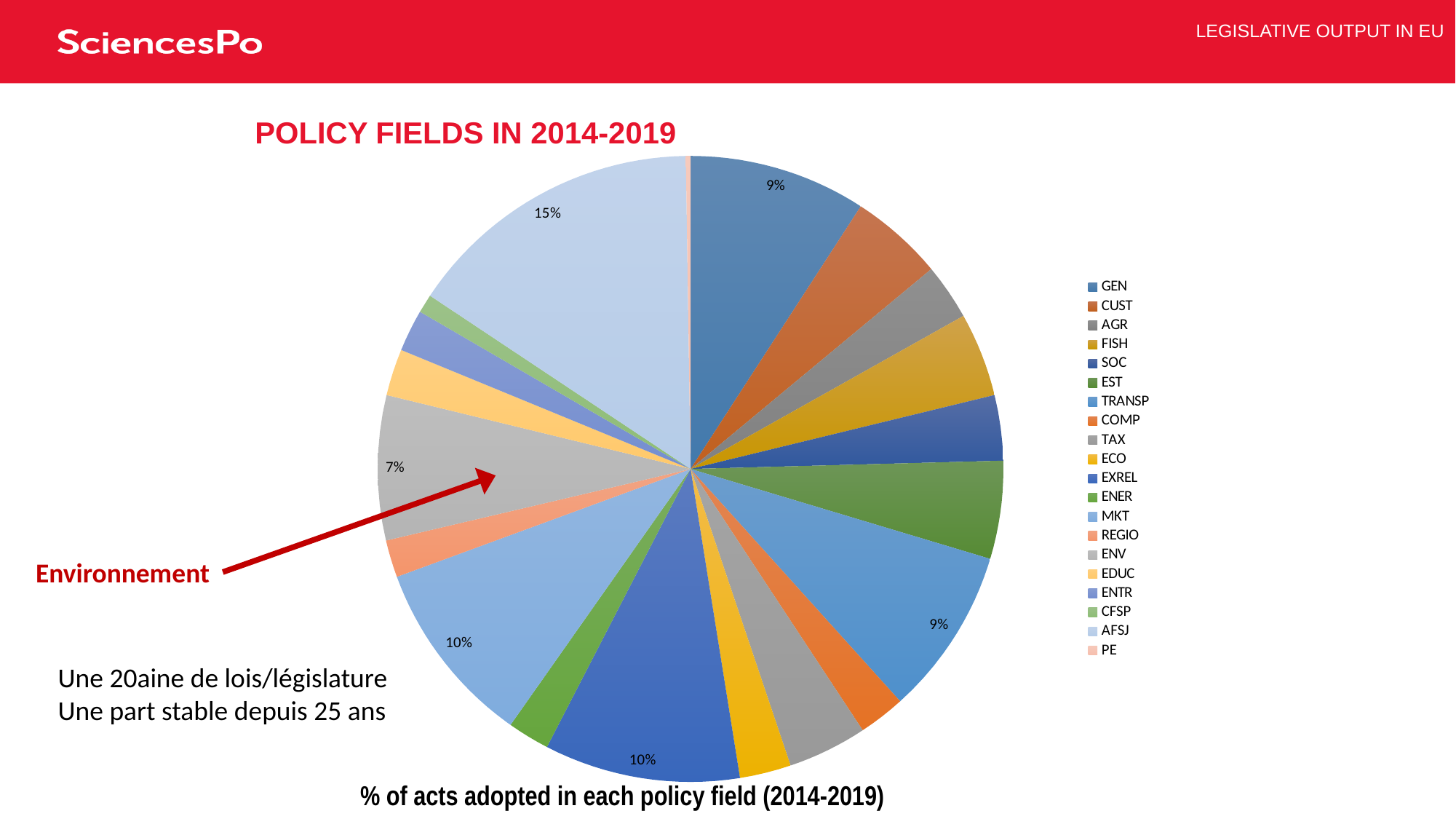
What share of the pie does the ENV slice represent? 7% Which slice is larger, AFSJ or MKT? AFSJ Which policy field has the largest share of the pie? AFSJ What kind of chart is shown on the slide? pie chart Which policy field has the smallest share of the pie? PE What is the difference in percentage points between the AFSJ slice and the ENV slice? 8 percentage points What is the value shown for the EXREL slice? 10% How many policy fields are listed in the legend? 20 What is the value shown for the MKT slice? 10% What is the value shown for the GEN slice? 9% What percentage of acts adopted in 2014-2019 falls in the AFSJ policy field? 15% What is the title of the chart? POLICY FIELDS IN 2014-2019